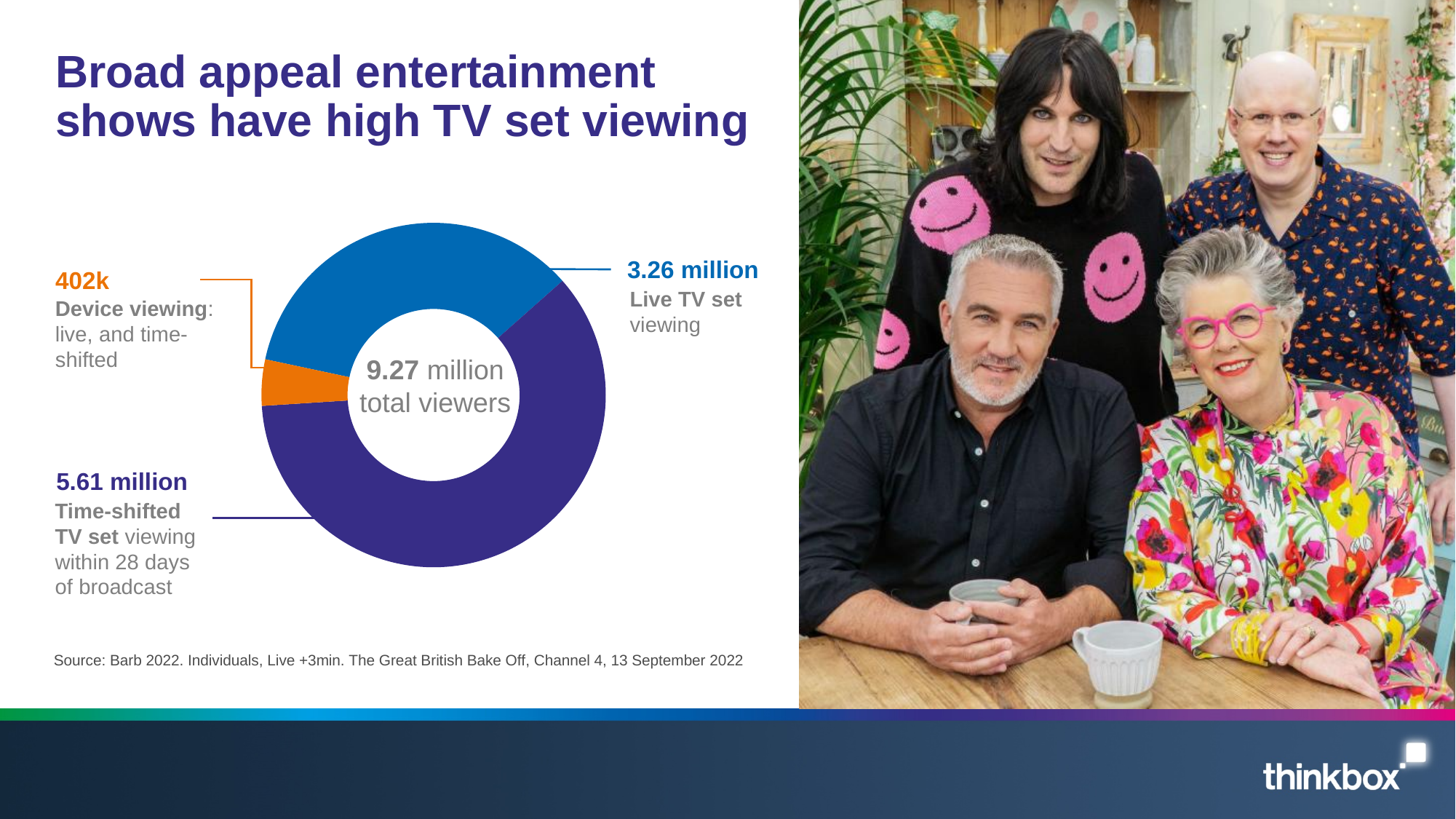
What colour is the Device viewing segment? Orange What is the value for Live TV set viewing? 3.26 million Which is larger, Live TV set viewing or Device viewing? Live TV set viewing What is the total number of viewers shown in the centre of the chart? 9.27 million What is the title of the slide? Broad appeal entertainment shows have high TV set viewing What kind of chart is shown on the slide? Donut (pie) chart Which viewing category has the smallest segment of the chart? Device viewing What is the difference between Time-shifted TV set viewing and Live TV set viewing? 2.35 million How many segments does the chart have? 3 What is the value for Device viewing (live and time-shifted)? 402k Which viewing category has the largest segment of the chart? Time-shifted TV set viewing What is the value for Time-shifted TV set viewing within 28 days of broadcast? 5.61 million